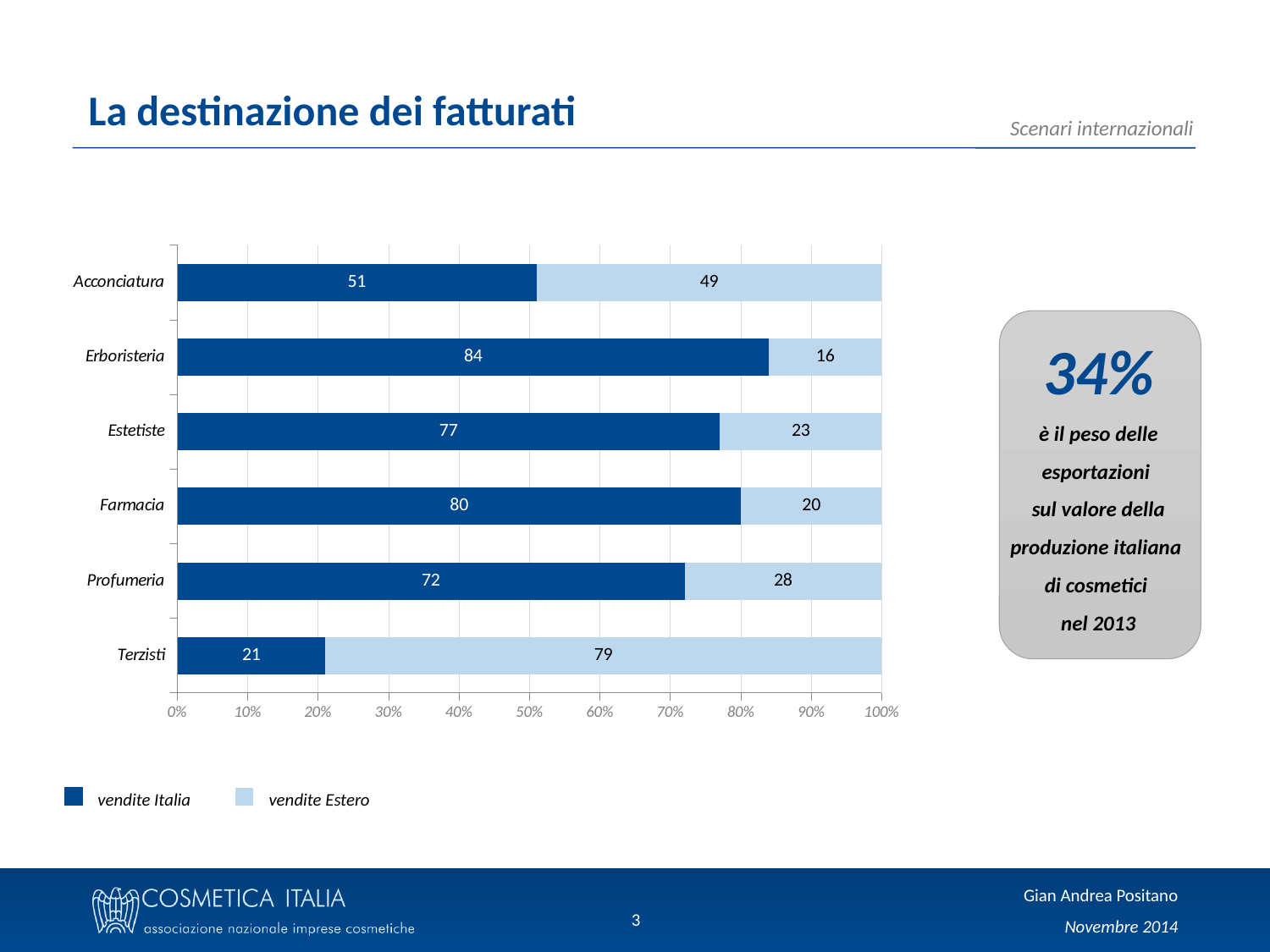
Which category has the lowest vendite Italia value? Terzisti What is the vendite Estero value for Farmacia? 20 What kind of chart is shown on the slide? Stacked bar chart What is the difference between the vendite Italia and vendite Estero values for Profumeria? 44 What is the vendite Estero value for Terzisti? 79 Which category has the highest vendite Italia value? Erboristeria What is the title of the chart on the slide? La destinazione dei fatturati What is the vendite Italia value for Erboristeria? 84 What is the total of the stacked bar for Farmacia? 100 How many series does the legend list? 2 How many categories are shown on the chart? 6 Which is larger: the vendite Estero value for Acconciatura or for Estetiste? Acconciatura